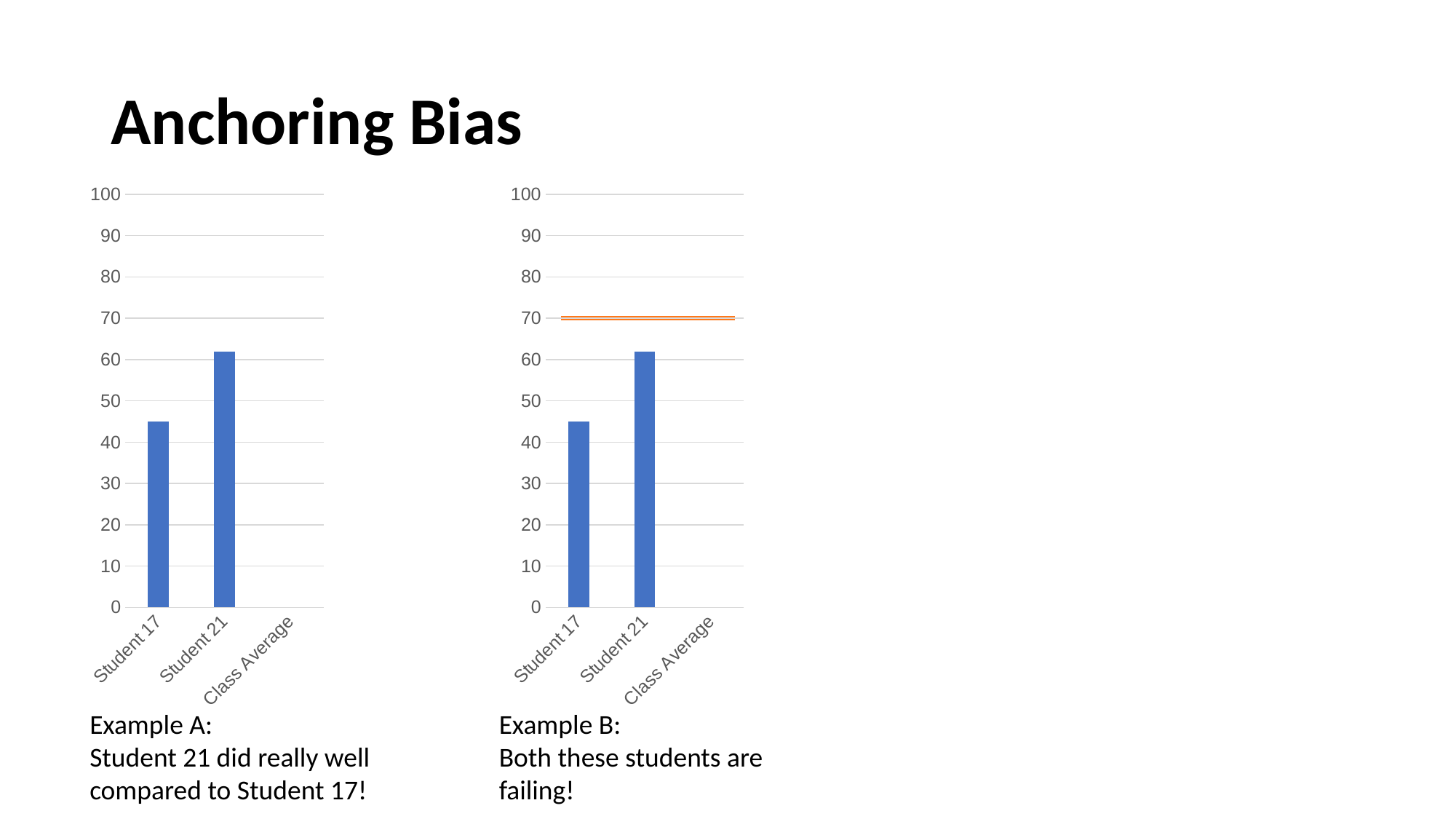
In the right chart (Example B), what colour is the horizontal line drawn near the 70 gridline? orange In the right chart (Example B), is the value for Student 21 greater or less than 70? less In the right chart (Example B), which of the two students has the lower bar? Student 17 In the left chart (Example A), is the value for Student 17 greater or less than 40? greater In the left chart (Example A), what is the label of the third category on the x axis? Class Average In the right chart (Example B), what is the highest value shown on the y axis? 100 In the left chart (Example A), which student has the higher bar, Student 17 or Student 21? Student 21 What kind of chart is the left chart (Example A)? bar chart In the left chart (Example A), how many categories are shown on the x axis? 3 In the right chart (Example B), is the value for Student 17 greater or less than 50? less